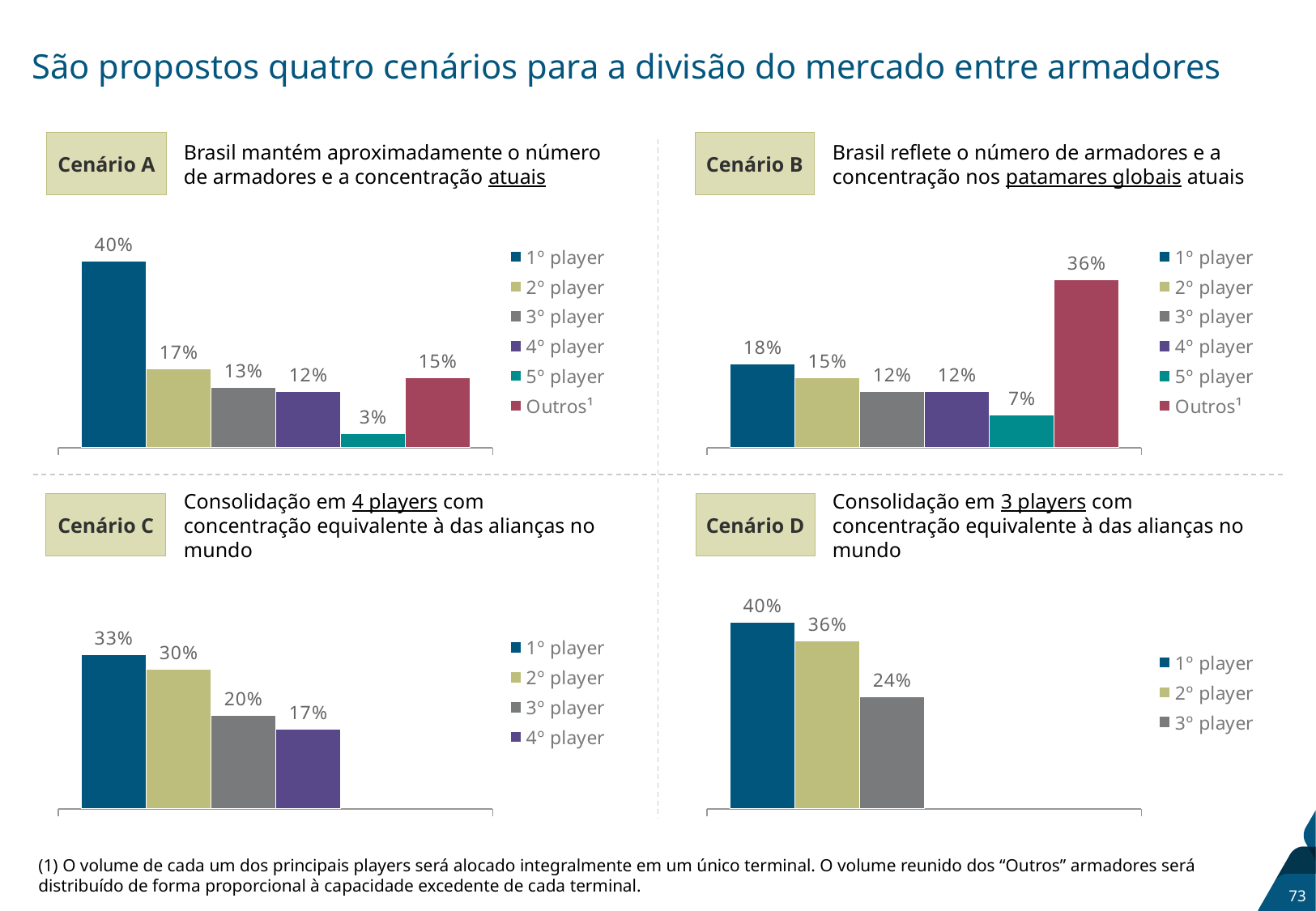
In the Cenário C chart, what is the value for 3º player? 20% In the Cenário B chart, what is the value for 5º player? 7% In the Cenário D chart, what is the difference between 2º player and 3º player? 12% In the Cenário A chart, what is the difference between 1º player and 2º player? 23% In the Cenário B chart, which category has the highest value? Outros In the Cenário A chart, which category has the lowest value? 5º player In the Cenário A chart, what is the value for 1º player? 40% In the Cenário C chart, do the values rise or fall from left to right? fall In the Cenário C chart, how many bars are plotted? 4 What kind of chart is the Cenário D chart? bar chart In the Cenário D chart, which is larger, 1º player or 2º player? 1º player In the Cenário B chart, how many series does the legend list? 6